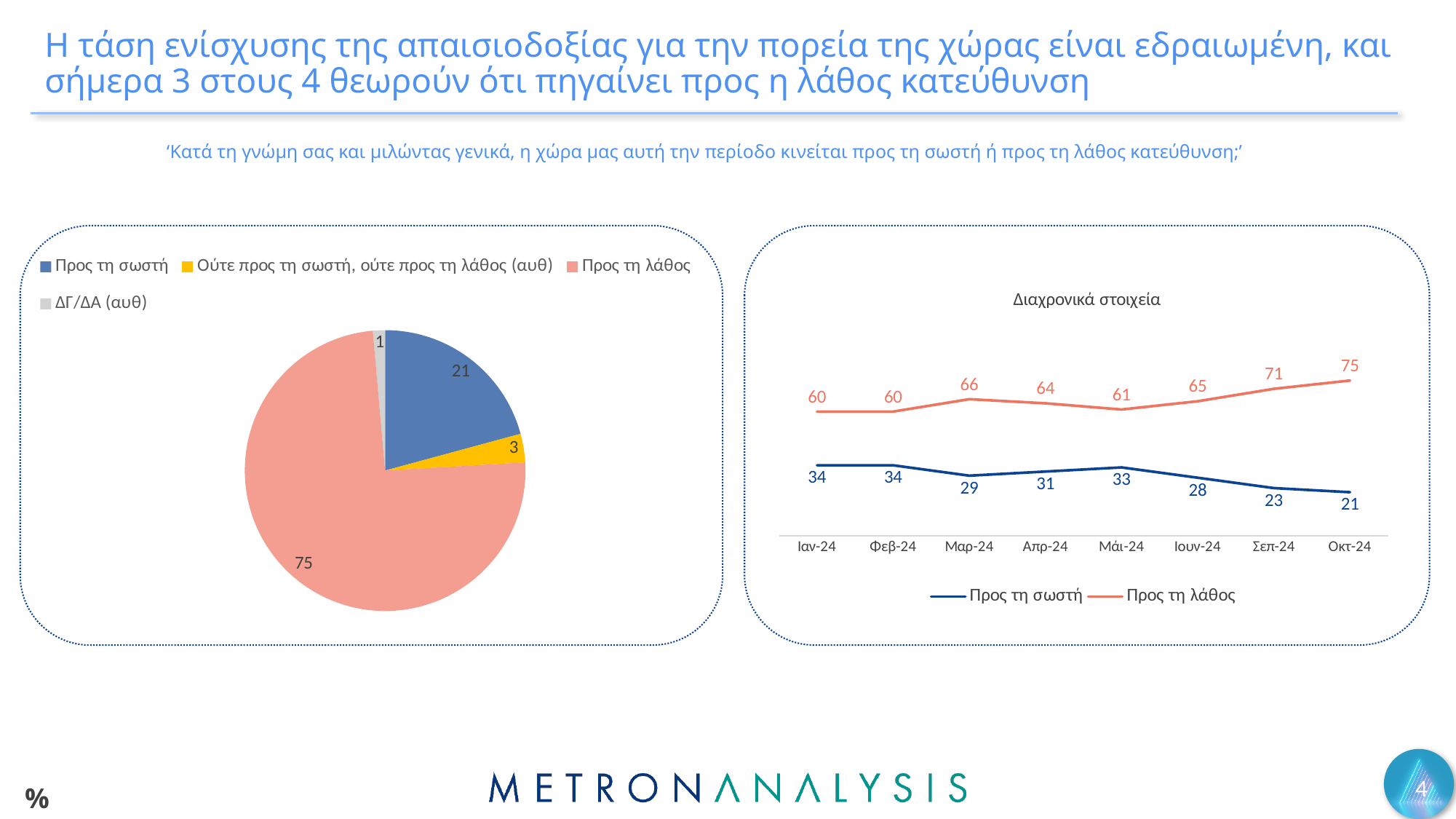
In the 'Διαχρονικά στοιχεία' chart, what is the value for 'Προς τη λάθος' in Μαρ-24? 66 In the pie chart on the left, what is the value for 'Προς τη λάθος'? 75 In the 'Διαχρονικά στοιχεία' chart, does 'Προς τη σωστή' rise or fall from Μάι-24 to Οκτ-24? fall In the pie chart on the left, which category has the smallest slice? ΔΓ/ΔΑ (αυθ) In the pie chart on the left, how many categories does the legend list? 4 In the pie chart on the left, what is the difference between 'Προς τη λάθος' and 'Προς τη σωστή'? 54 In the pie chart on the left, what is the value for 'Προς τη σωστή'? 21 In the 'Διαχρονικά στοιχεία' chart, what is the value for 'Προς τη σωστή' in Σεπ-24? 23 In the 'Διαχρονικά στοιχεία' chart, how many time points are shown on the x axis? 8 What kind of chart is the 'Διαχρονικά στοιχεία' chart on the right? line chart In the 'Διαχρονικά στοιχεία' chart, in which month does 'Προς τη λάθος' reach its highest value? Οκτ-24 In the 'Διαχρονικά στοιχεία' chart, what is the difference between 'Προς τη λάθος' and 'Προς τη σωστή' in Ιαν-24? 26